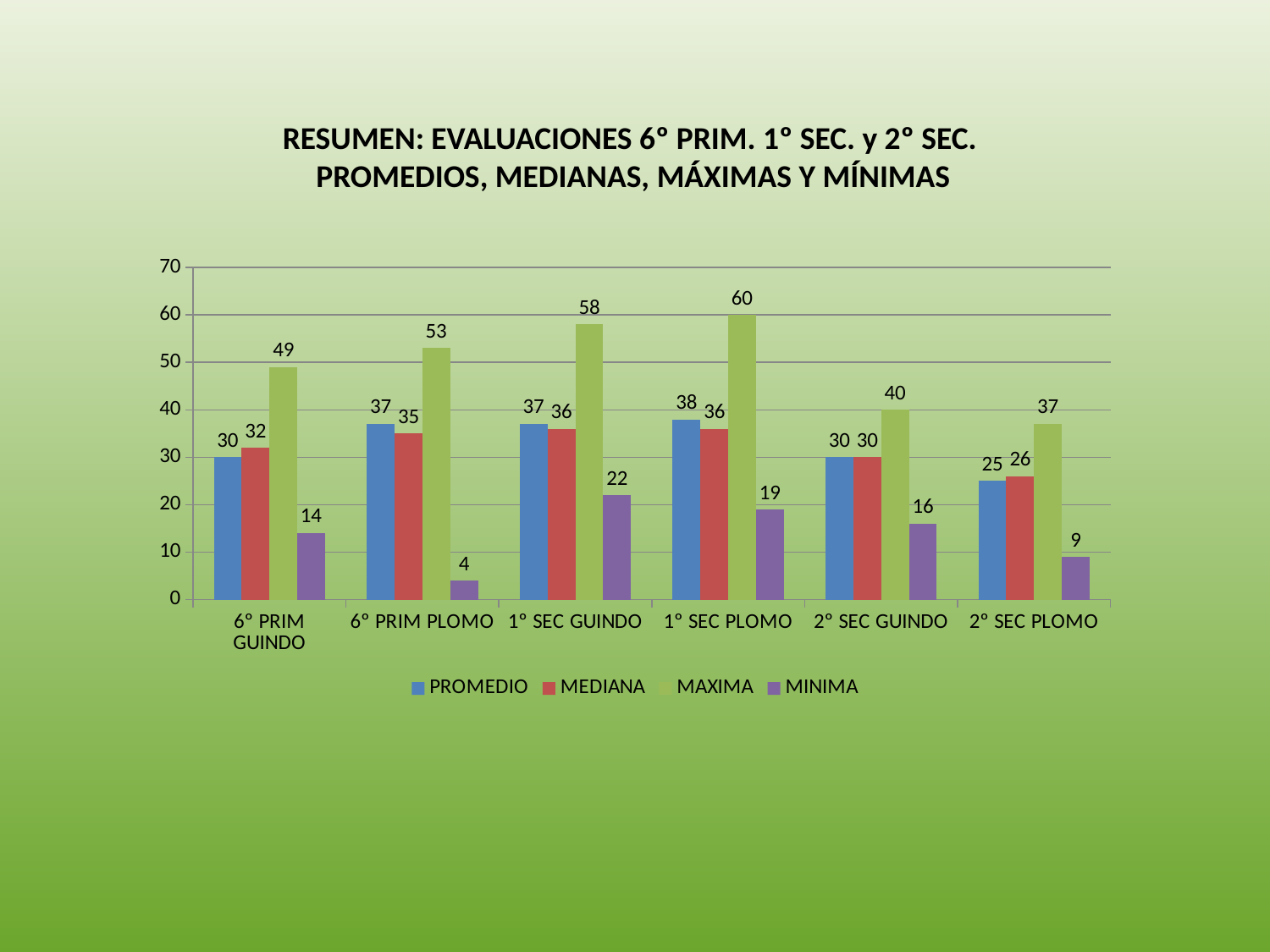
What is the MINIMA value for 6° PRIM PLOMO? 4 What kind of chart is shown on the slide? Bar chart What is the difference between the MAXIMA and MINIMA values for 1° SEC GUINDO? 36 Which series is shown in purple? MINIMA How many categories are shown on the x axis? 6 Which is larger, the PROMEDIO for 1° SEC PLOMO or the PROMEDIO for 2° SEC GUINDO? 1° SEC PLOMO Which category has the lowest MINIMA value? 6° PRIM PLOMO Which category has the highest MAXIMA value? 1° SEC PLOMO How many series does the legend list? 4 What is the PROMEDIO value for 2° SEC PLOMO? 25 What is the MAXIMA value for 1° SEC PLOMO? 60 What is the MEDIANA value for 6° PRIM GUINDO? 32